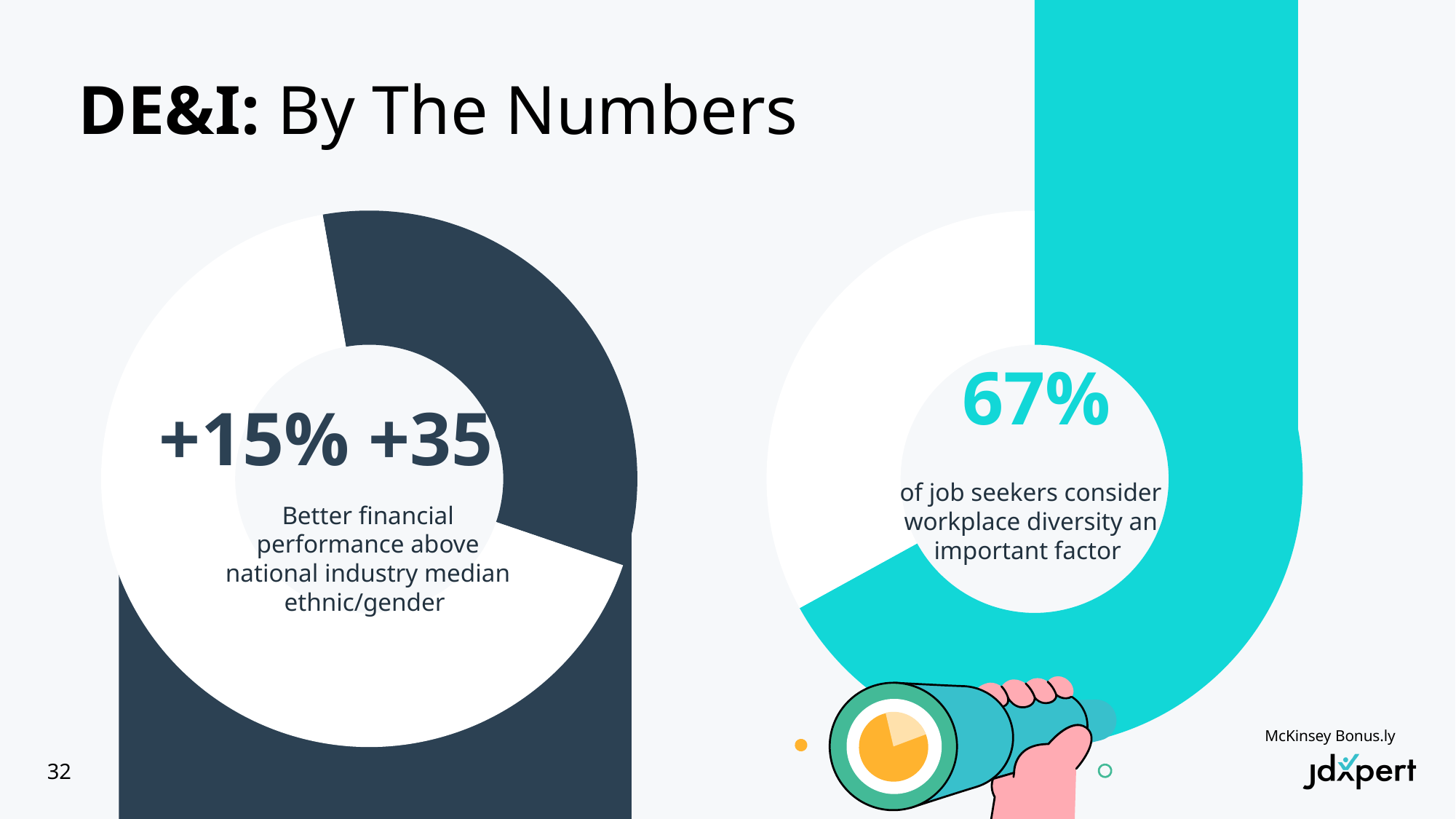
How many donut charts are shown on the slide? 2 In the left-hand chart, what is the second figure shown next to +15%? +35 What does the left-hand chart's label say the +15% / +35 figures measure? Better financial performance above national industry median ethnic/gender What kind of chart is used on the right side of the slide to show the 67% figure? Donut (pie) chart In the left-hand chart, what is the first figure shown for better financial performance above the national industry median? +15% In the right-hand chart, what percentage of job seekers consider workplace diversity an important factor? 67% What is the title of the slide containing the two charts? DE&I: By The Numbers What colour is the filled ring of the right-hand chart showing 67%? Teal In the right-hand chart, is the share of job seekers who consider workplace diversity important greater or less than 50%? greater